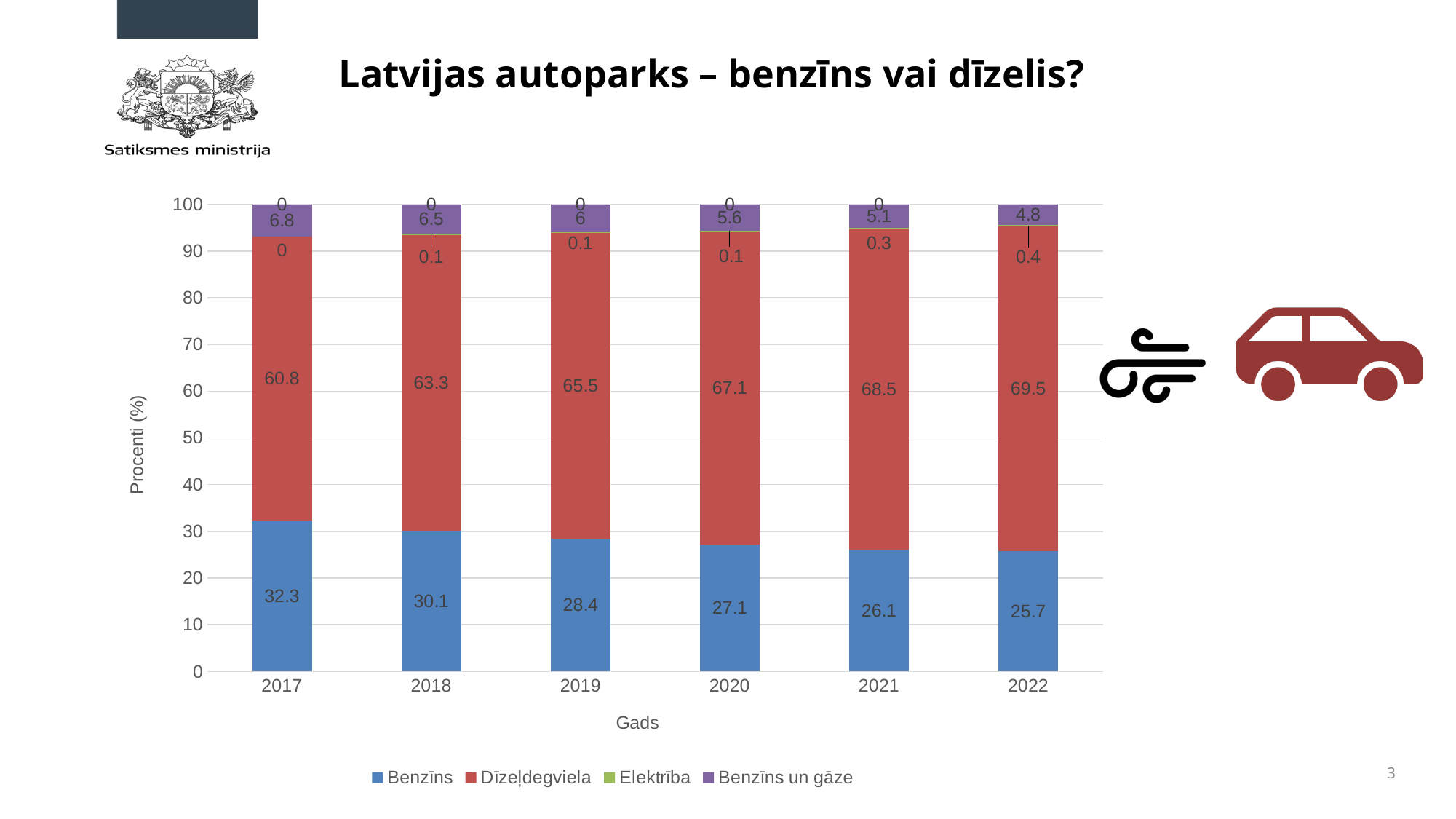
What type of chart is shown on the slide? Stacked bar chart How many years are shown on the x axis? 6 Does the Benzīns value rise or fall from 2017 to 2022? Fall In which year is the Benzīns value lowest? 2022 Which is larger in 2019: the Benzīns value or the Dīzeļdegviela value? Dīzeļdegviela What is the difference between the Dīzeļdegviela values in 2022 and 2017? 8.7 In which year is the Dīzeļdegviela value highest? 2022 What is the value for Dīzeļdegviela in 2022? 69.5 What is the value for Benzīns un gāze in 2020? 5.6 What is the value for Benzīns in 2017? 32.3 What is the value for Elektrība in 2021? 0.3 How many series does the legend list? 4